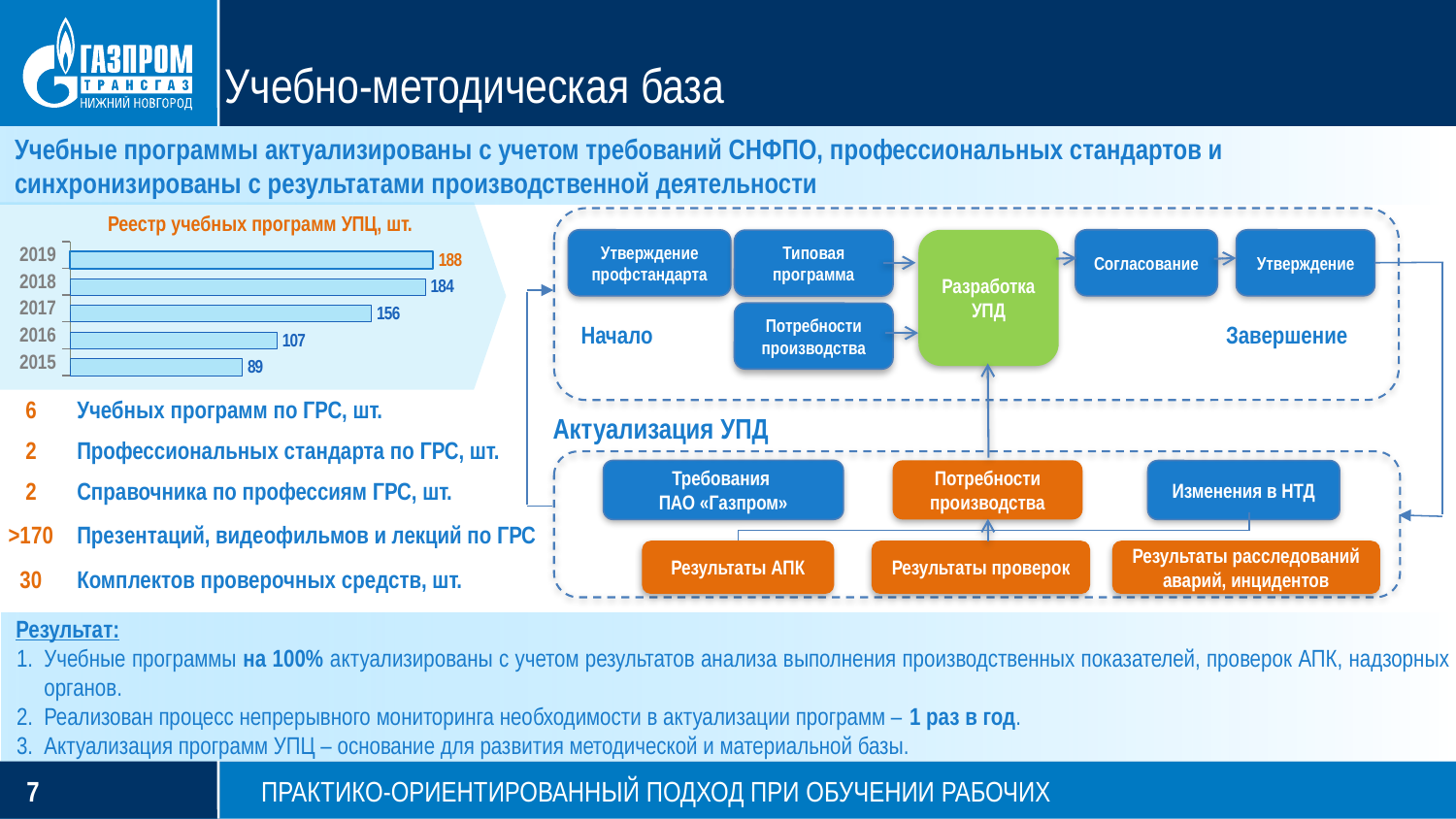
How many years are shown in the chart 'Реестр учебных программ УПЦ, шт.'? 5 What is the title of the bar chart on the left of the slide? Реестр учебных программ УПЦ, шт. What is the value for 2019 in the chart 'Реестр учебных программ УПЦ, шт.'? 188 Which year has the highest value in the chart 'Реестр учебных программ УПЦ, шт.'? 2019 Do the values in the chart 'Реестр учебных программ УПЦ, шт.' rise or fall from 2015 to 2019? rise In the chart 'Реестр учебных программ УПЦ, шт.', which is larger: the value for 2016 or the value for 2017? 2017 What kind of chart is 'Реестр учебных программ УПЦ, шт.'? bar chart What is the difference between the values for 2018 and 2017 in the chart 'Реестр учебных программ УПЦ, шт.'? 28 What is the value for 2017 in the chart 'Реестр учебных программ УПЦ, шт.'? 156 Which year has the lowest value in the chart 'Реестр учебных программ УПЦ, шт.'? 2015 What is the value for 2015 in the chart 'Реестр учебных программ УПЦ, шт.'? 89 What is the difference between the values for 2019 and 2015 in the chart 'Реестр учебных программ УПЦ, шт.'? 99